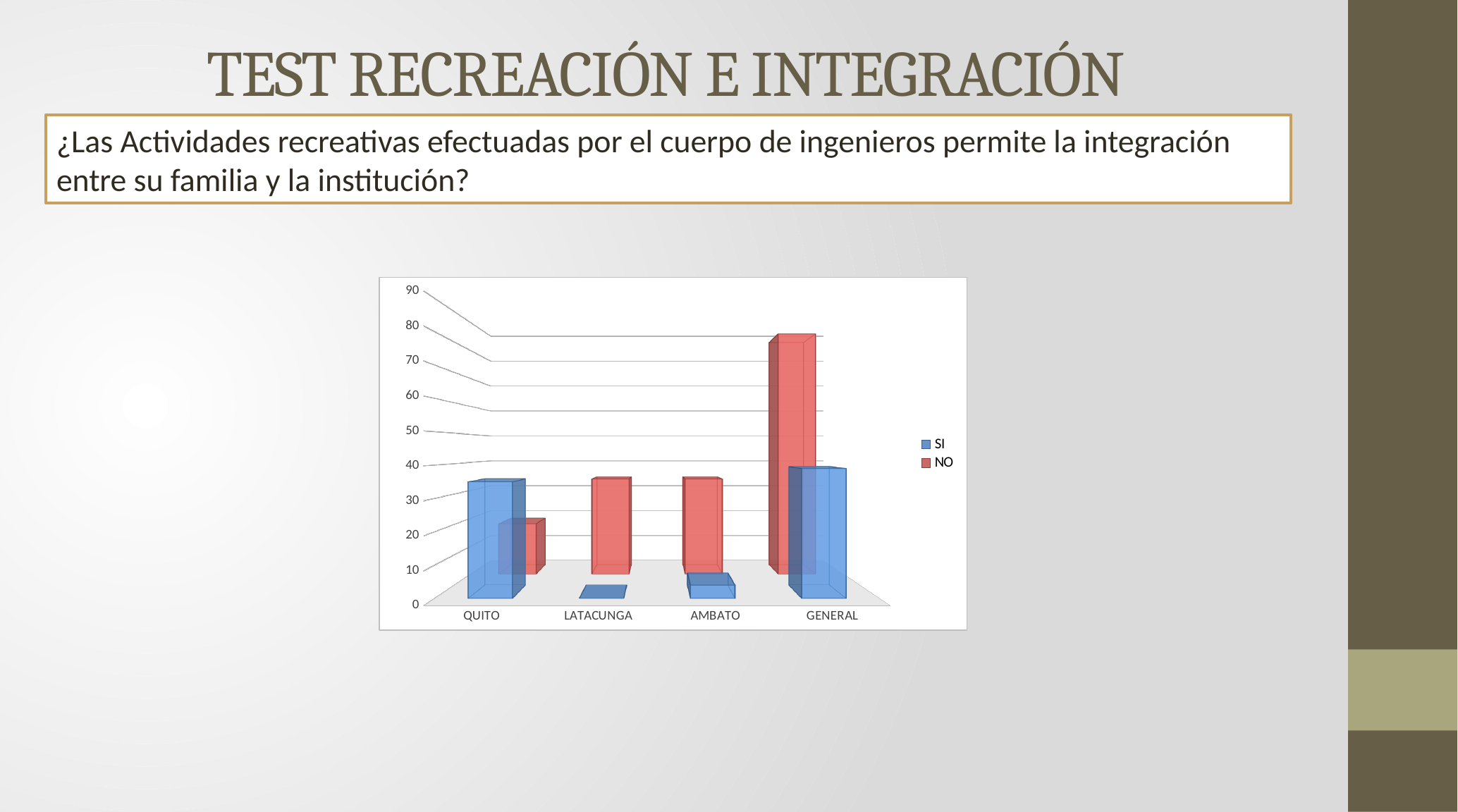
Which category has the lowest NO value? QUITO Is the NO value for GENERAL greater or less than 60? greater How many categories are shown on the x axis of the chart? 4 How many series does the chart's legend list? 2 Which category has the highest NO value? GENERAL Is the NO value for QUITO greater or less than 30? less For QUITO, which is larger, the SI value or the NO value? SI Is the SI value for LATACUNGA greater or less than 10? less Which colour represents the NO series in the chart? red What kind of chart is shown on the slide? bar chart Which category has the highest SI value? GENERAL